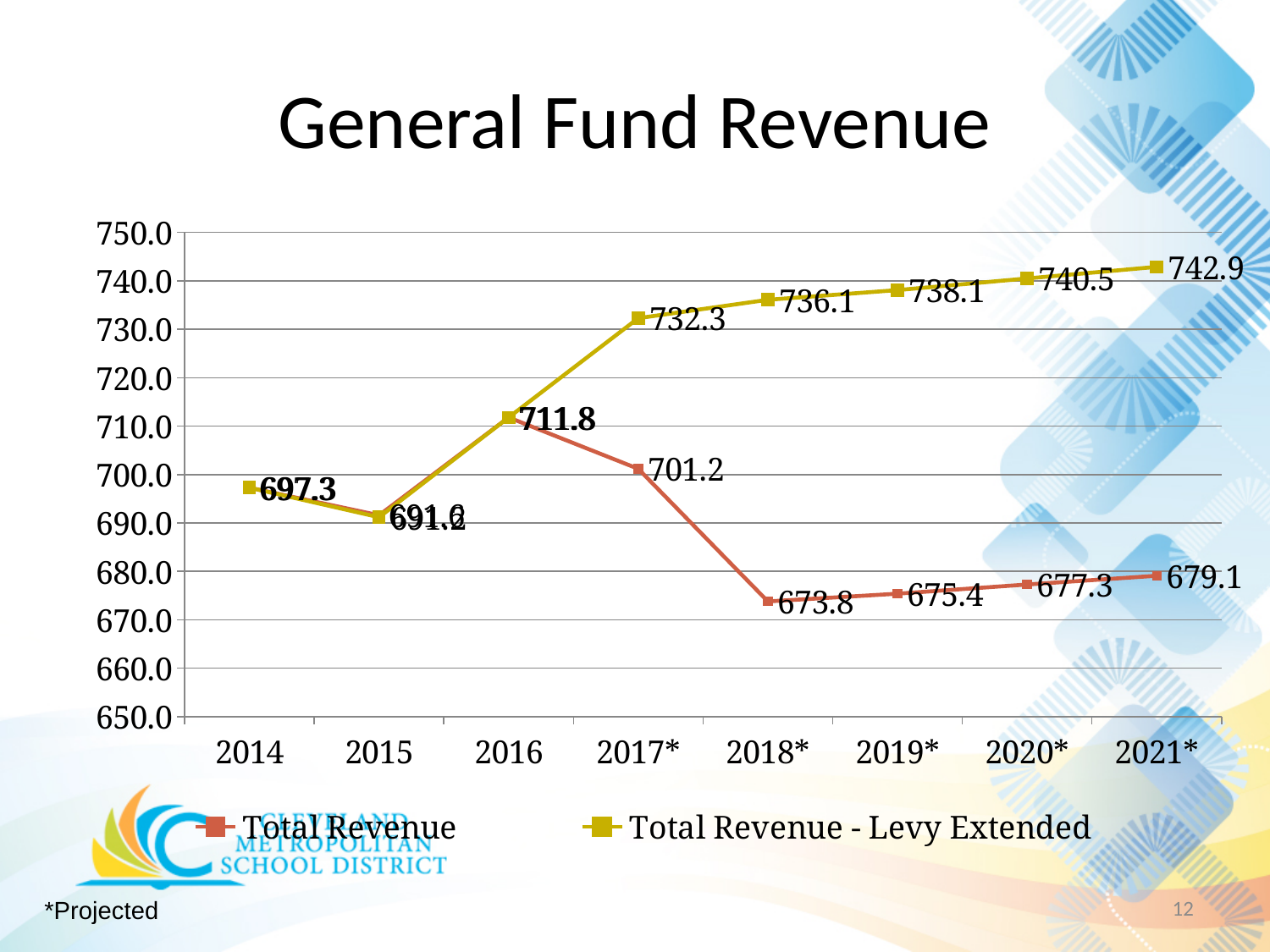
What is the difference between Total Revenue - Levy Extended and Total Revenue in 2021*? 63.8 In which year is Total Revenue lowest? 2018* What is the value for Total Revenue - Levy Extended in 2019*? 738.1 What is the title of the chart? General Fund Revenue What is the value for Total Revenue in 2018*? 673.8 How many years are shown on the x axis? 8 In which year is Total Revenue - Levy Extended highest? 2021* What is the value for Total Revenue - Levy Extended in 2021*? 742.9 How many series does the legend list? 2 Which is larger in 2020*: Total Revenue or Total Revenue - Levy Extended? Total Revenue - Levy Extended What is the value for Total Revenue in 2017*? 701.2 What type of chart is shown on the slide? line chart